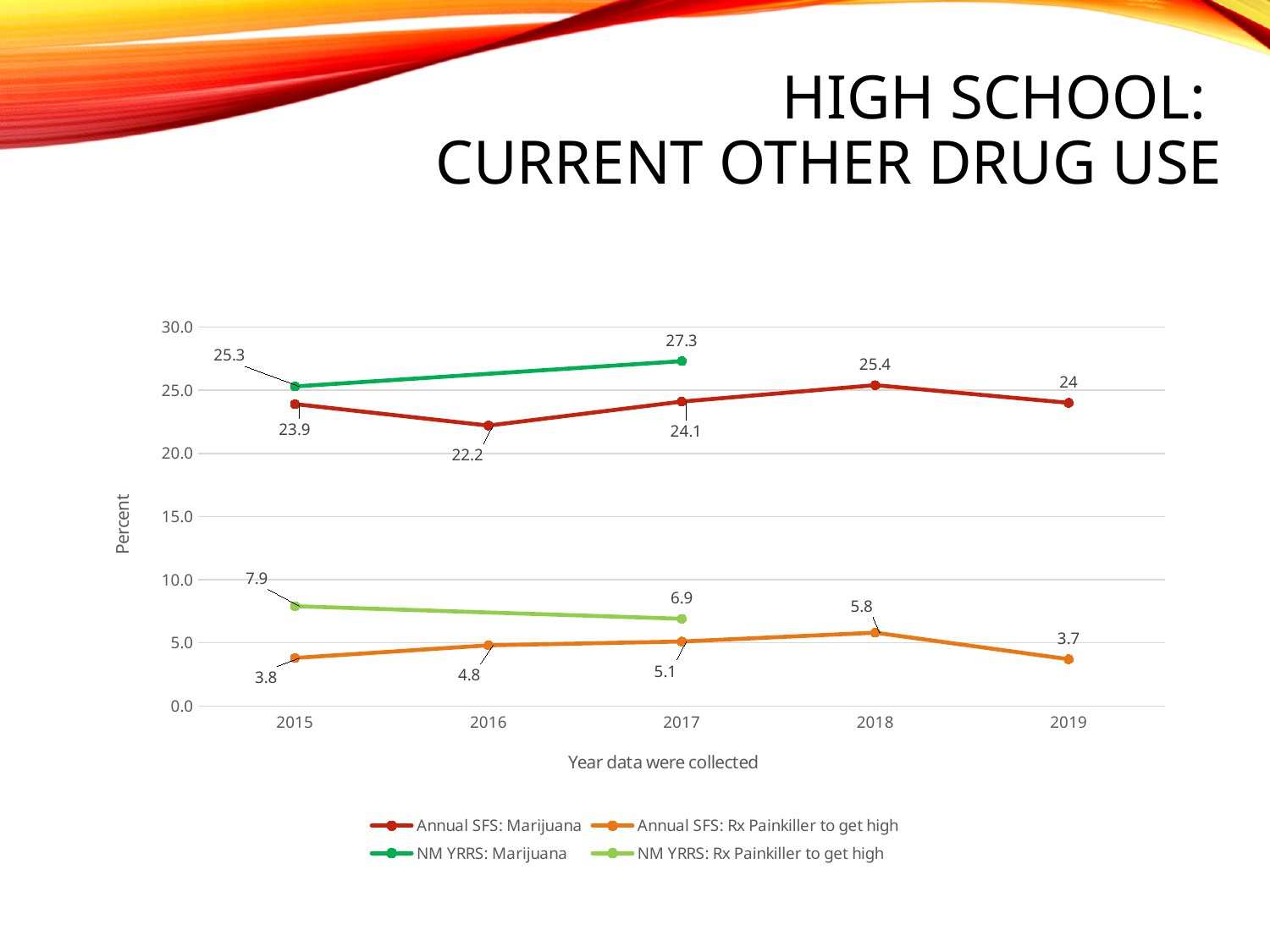
What is the value for NM YRRS: Marijuana in 2017? 27.3 How many series does the legend list? 4 In 2015, which is larger: NM YRRS: Marijuana or Annual SFS: Marijuana? NM YRRS: Marijuana In which year is the Annual SFS: Marijuana series lowest? 2016 What kind of chart is shown on the slide? Line chart In which year is the Annual SFS: Rx Painkiller to get high series highest? 2018 By how much did NM YRRS: Marijuana increase from 2015 to 2017? 2.0 What is the value for Annual SFS: Marijuana in 2018? 25.4 What is the value for Annual SFS: Rx Painkiller to get high in 2019? 3.7 What is the difference between Annual SFS: Marijuana in 2017 and in 2016? 1.9 How many years are shown on the x axis? 5 In which year is the Annual SFS: Marijuana series highest? 2018